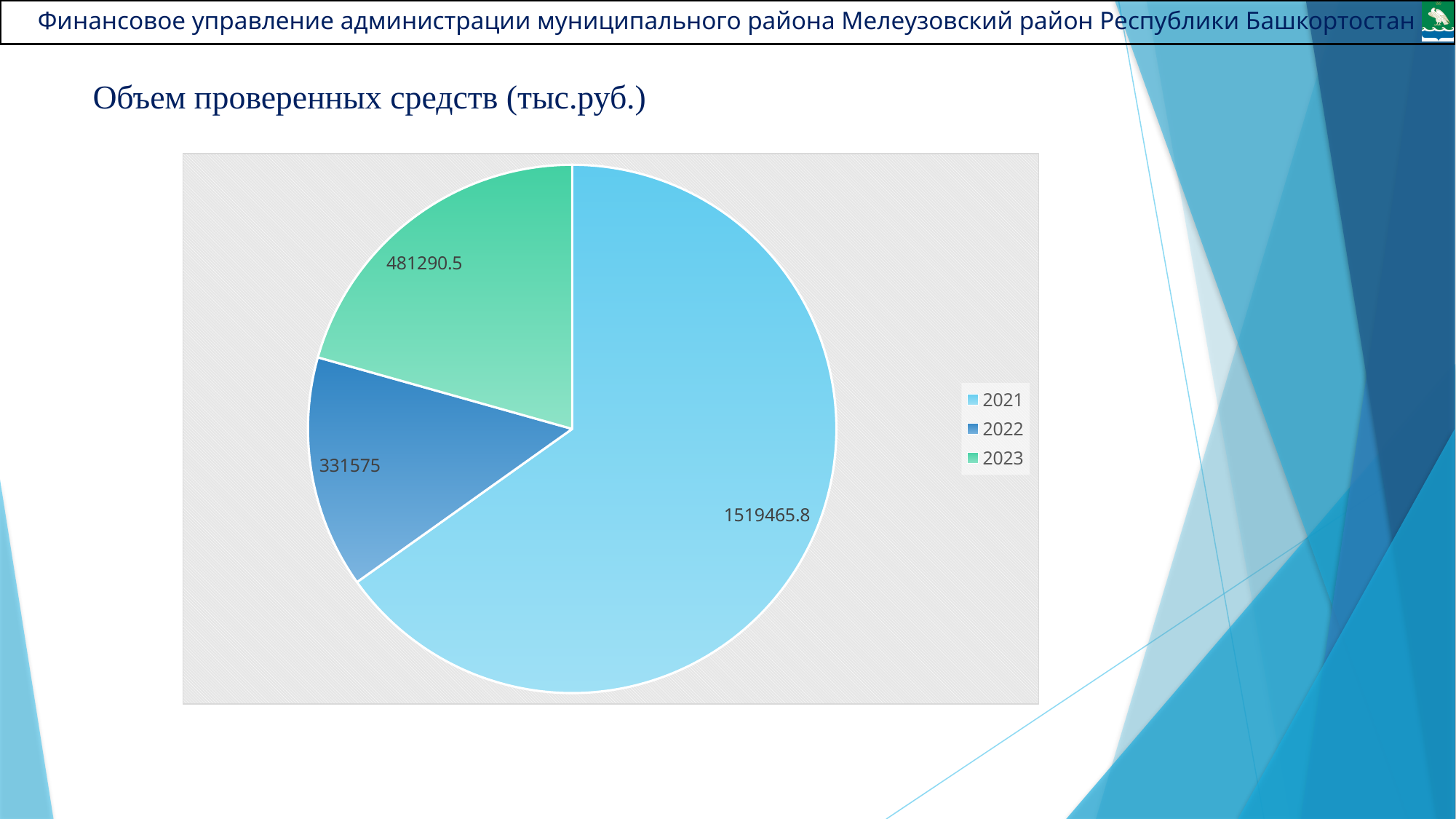
Which year has the smallest slice in the pie chart? 2022 What is the difference between the values for 2021 and 2022? 1187890.8 What is the title of the chart on the slide? Объем проверенных средств (тыс.руб.) Which is larger, the value for 2022 or the value for 2023? 2023 What type of chart is shown on the slide? pie chart What is the value for 2021 in the pie chart? 1519465.8 What is the value for 2023 in the pie chart? 481290.5 How many slices does the pie chart have? 3 Which year has the largest slice in the pie chart? 2021 How many entries does the legend list? 3 What is the value for 2022 in the pie chart? 331575 What is the difference between the values for 2023 and 2022? 149715.5